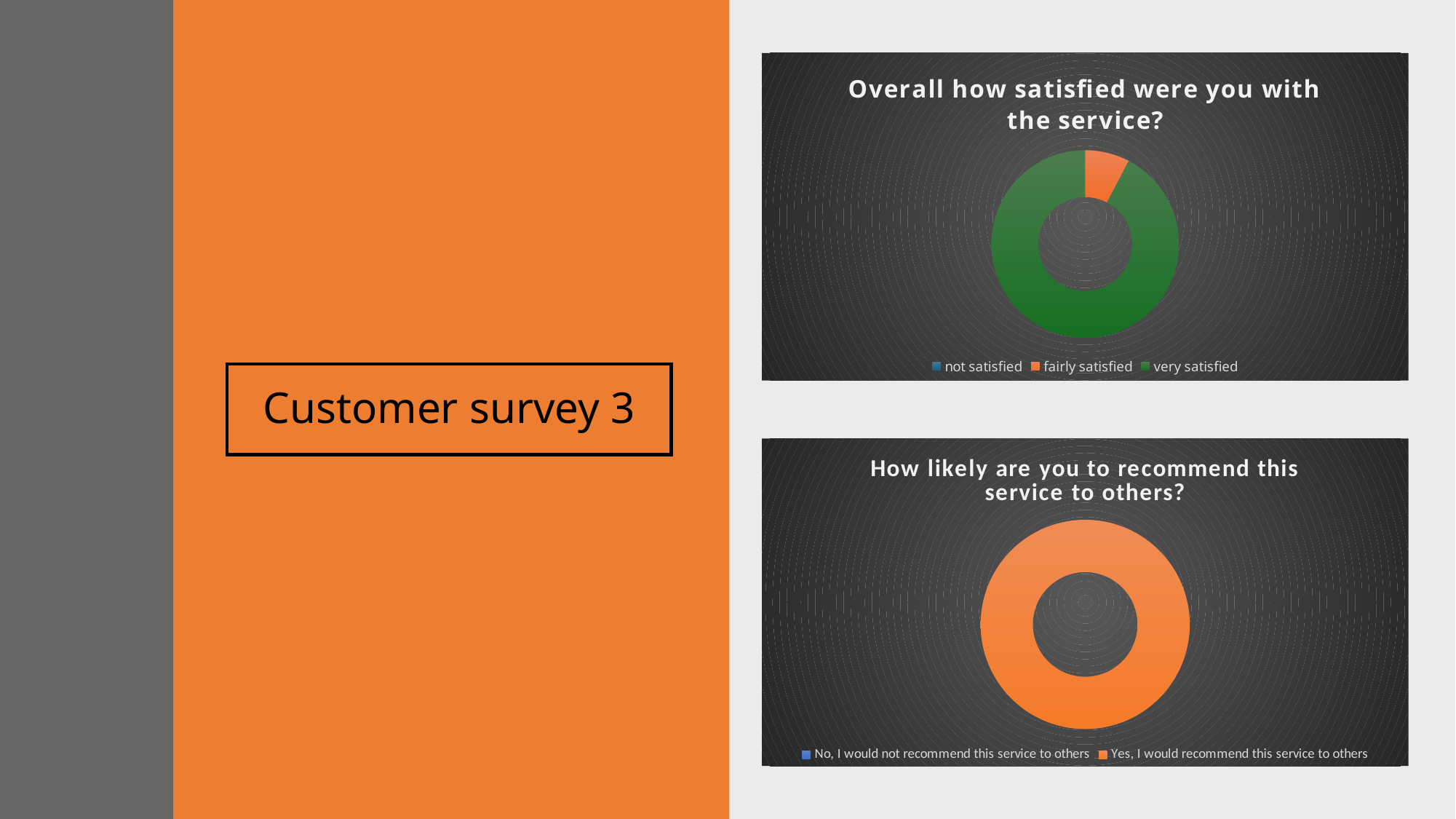
In the top chart, 'Overall how satisfied were you with the service?', what colour represents 'very satisfied'? green In the top chart, 'Overall how satisfied were you with the service?', how many entries does the legend list? 3 In the bottom chart, 'How likely are you to recommend this service to others?', which is larger: 'No, I would not recommend this service to others' or 'Yes, I would recommend this service to others'? Yes, I would recommend this service to others In the bottom chart, 'How likely are you to recommend this service to others?', how many entries does the legend list? 2 What is the title of the bottom chart on the slide? How likely are you to recommend this service to others? In the bottom chart, 'How likely are you to recommend this service to others?', which category has the largest share? Yes, I would recommend this service to others What kind of chart is the bottom chart, 'How likely are you to recommend this service to others?'? doughnut chart In the top chart, 'Overall how satisfied were you with the service?', which category has the smallest share? not satisfied In the top chart, 'Overall how satisfied were you with the service?', which category has the largest share? very satisfied What kind of chart is the top chart, 'Overall how satisfied were you with the service?'? doughnut chart In the top chart, 'Overall how satisfied were you with the service?', which is larger: fairly satisfied or very satisfied? very satisfied